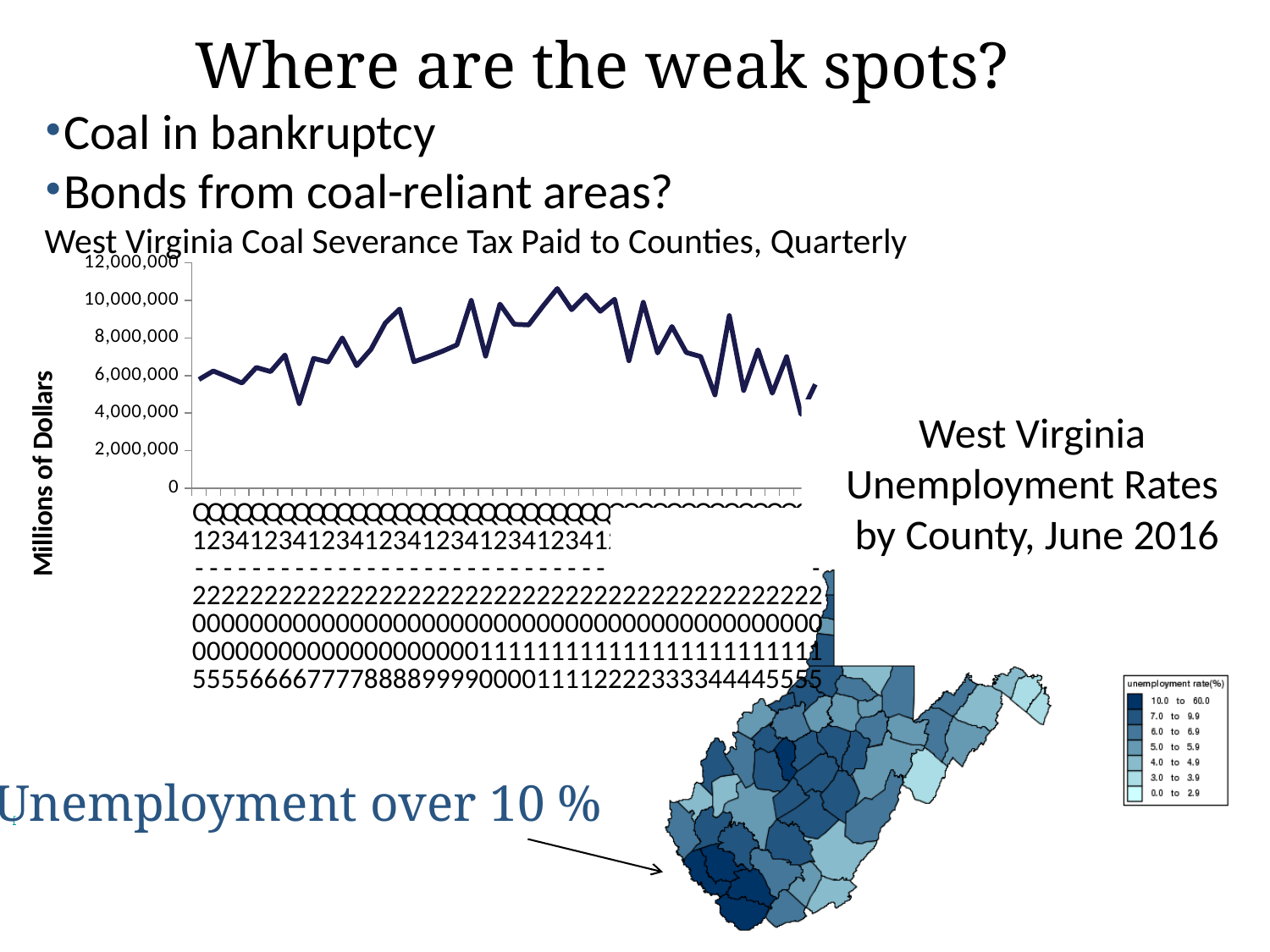
In the line chart, is the last plotted value greater or less than 6,000,000? less In the line chart, is the lowest plotted value greater or less than 6,000,000? less In the line chart, is the first plotted value greater or less than 8,000,000? less What is the title of the line chart on the slide? West Virginia Coal Severance Tax Paid to Counties, Quarterly What is the highest value shown on the vertical axis of the line chart? 12,000,000 What is the label on the vertical axis of the line chart? Millions of Dollars What kind of chart is 'West Virginia Coal Severance Tax Paid to Counties, Quarterly'? line chart In the line chart, do the values generally rise or fall from the start of the series to the peak near the middle? rise